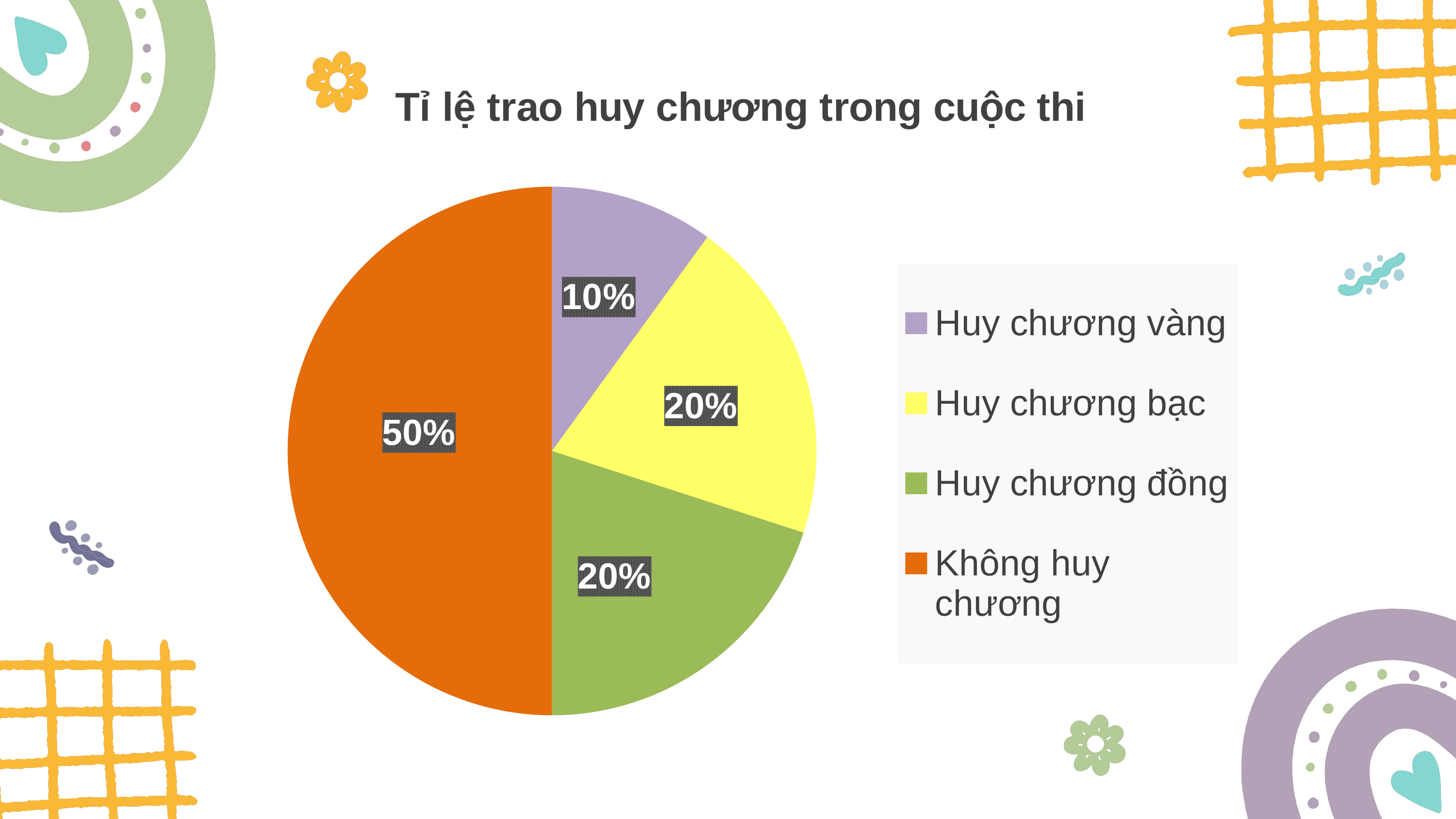
What colour is the slice for Huy chương đồng? Green Which is larger, the share for Huy chương bạc or the share for Huy chương vàng? Huy chương bạc What is the difference between the share for Không huy chương and the share for Huy chương đồng? 30% What percentage is shown for Huy chương bạc? 20% What type of chart is shown on the slide? Pie chart Which category has the smallest share of the pie? Huy chương vàng How many slices does the pie chart have? 4 What percentage is shown for Không huy chương? 50% How many entries does the legend list? 4 Which category has the largest share of the pie? Không huy chương What is the title of the chart? Tỉ lệ trao huy chương trong cuộc thi What percentage is shown for Huy chương vàng? 10%